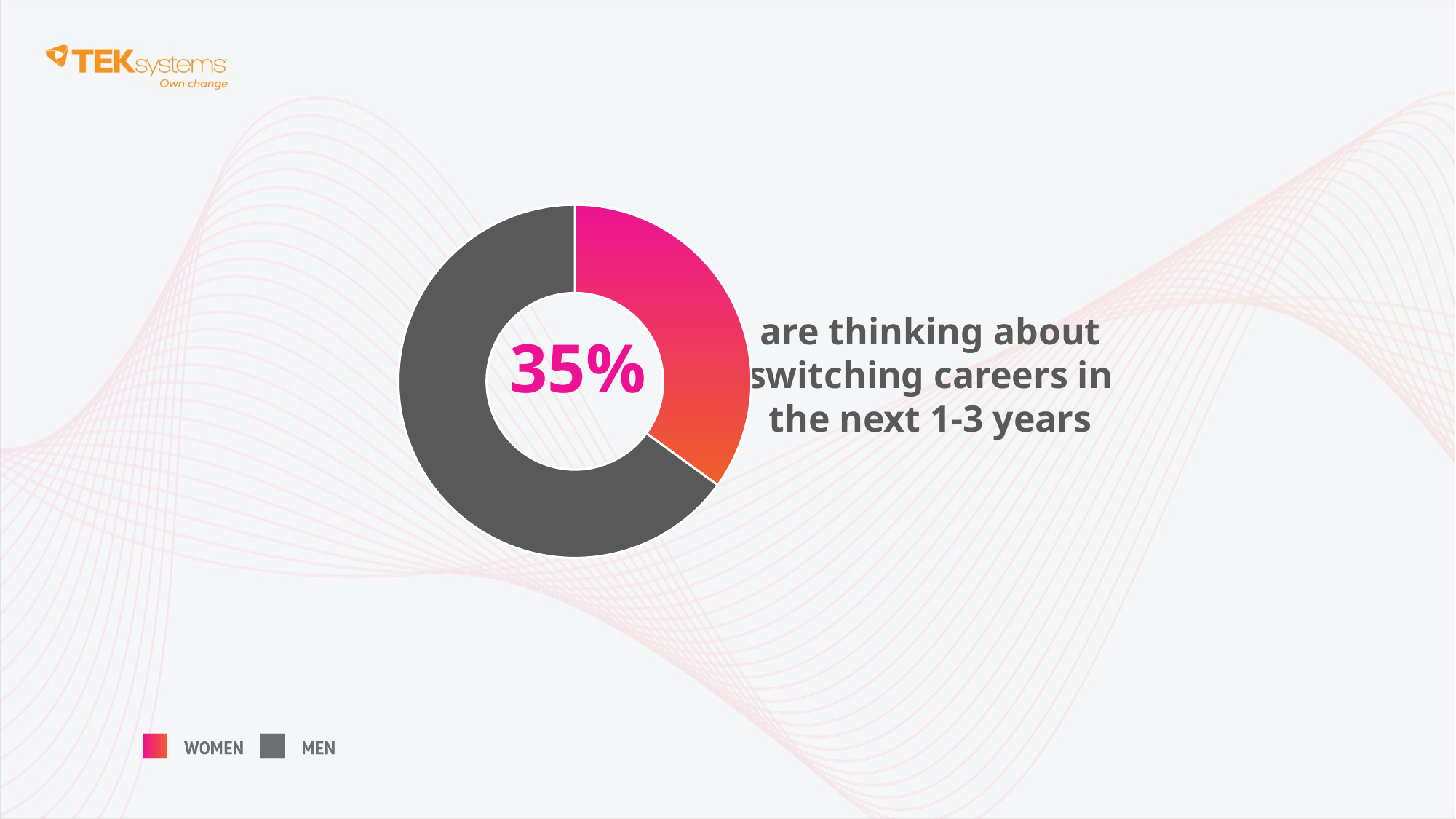
What does the text next to the donut chart say the 35% are thinking about? switching careers in the next 1-3 years What percentage is printed in the centre of the donut chart? 35% What kind of chart is shown on the slide? pie chart (donut) Which category has the largest slice in the donut chart? Men How many slices does the donut chart have? 2 Which slice of the donut chart is larger, Women or Men? Men Is the Men slice of the donut chart greater or less than 50%? greater Which category has the smallest slice in the donut chart? Women What colour represents Men in the donut chart? grey Is the Women slice of the donut chart greater or less than 50%? less What share of the donut chart does the Women slice represent? 35% How many categories does the legend list? 2